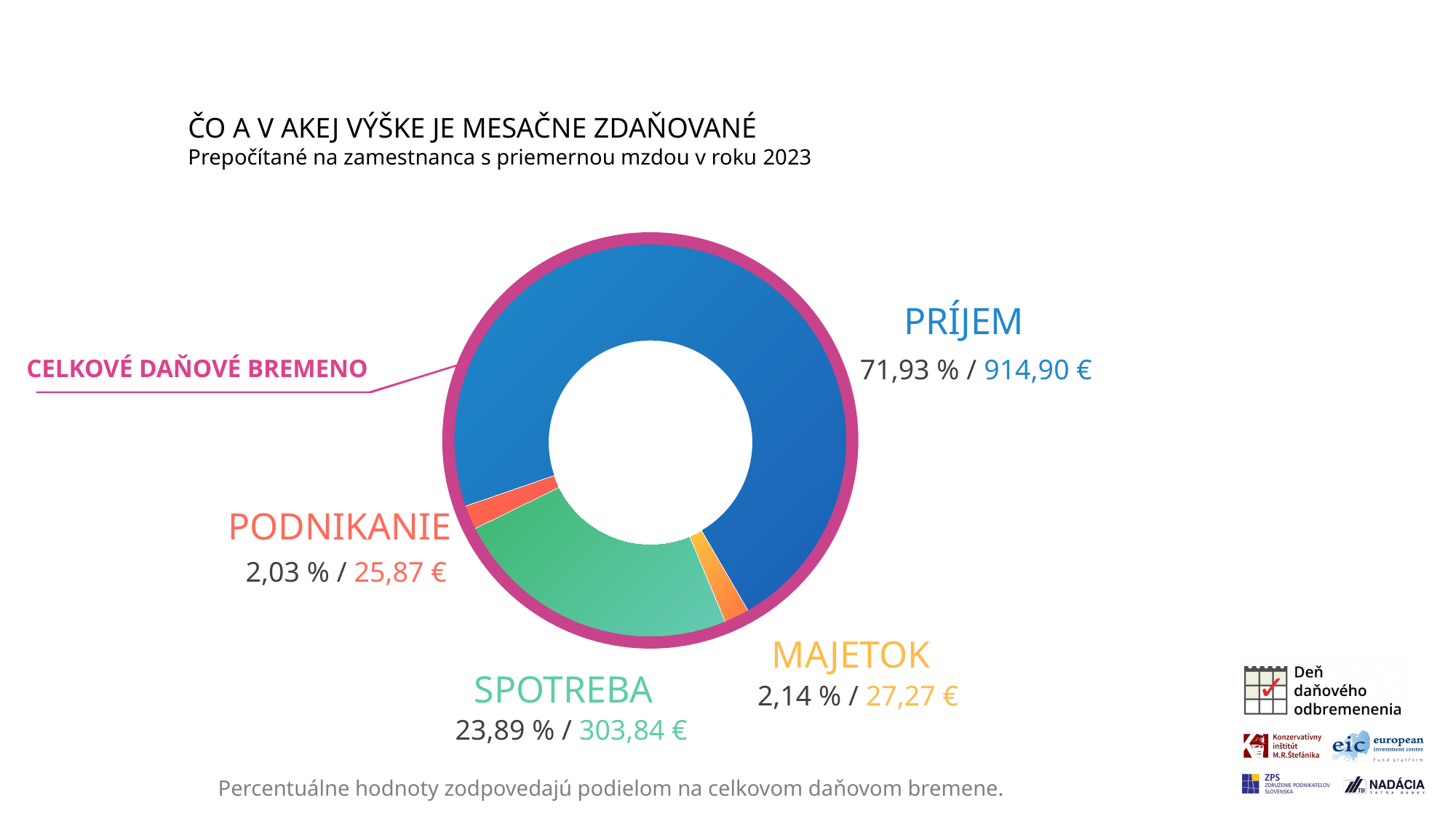
What kind of chart is shown on the slide? Donut (pie) chart Which category has the smallest share of the total tax burden? PODNIKANIE Which is larger, the amount for MAJETOK or the amount for PODNIKANIE? MAJETOK What percentage share is shown for PRÍJEM? 71,93 % How many categories does the donut chart show? 4 What is the difference in percentage points between PRÍJEM and SPOTREBA? 48,04 % What percentage share is shown for MAJETOK? 2,14 % What monthly amount in euros is shown for PODNIKANIE? 25,87 € What is the difference in euros between PRÍJEM and SPOTREBA? 611,06 € Which category has the largest share of the total tax burden? PRÍJEM What label is attached to the pink outer ring of the donut chart? CELKOVÉ DAŇOVÉ BREMENO What monthly amount in euros is shown for SPOTREBA? 303,84 €